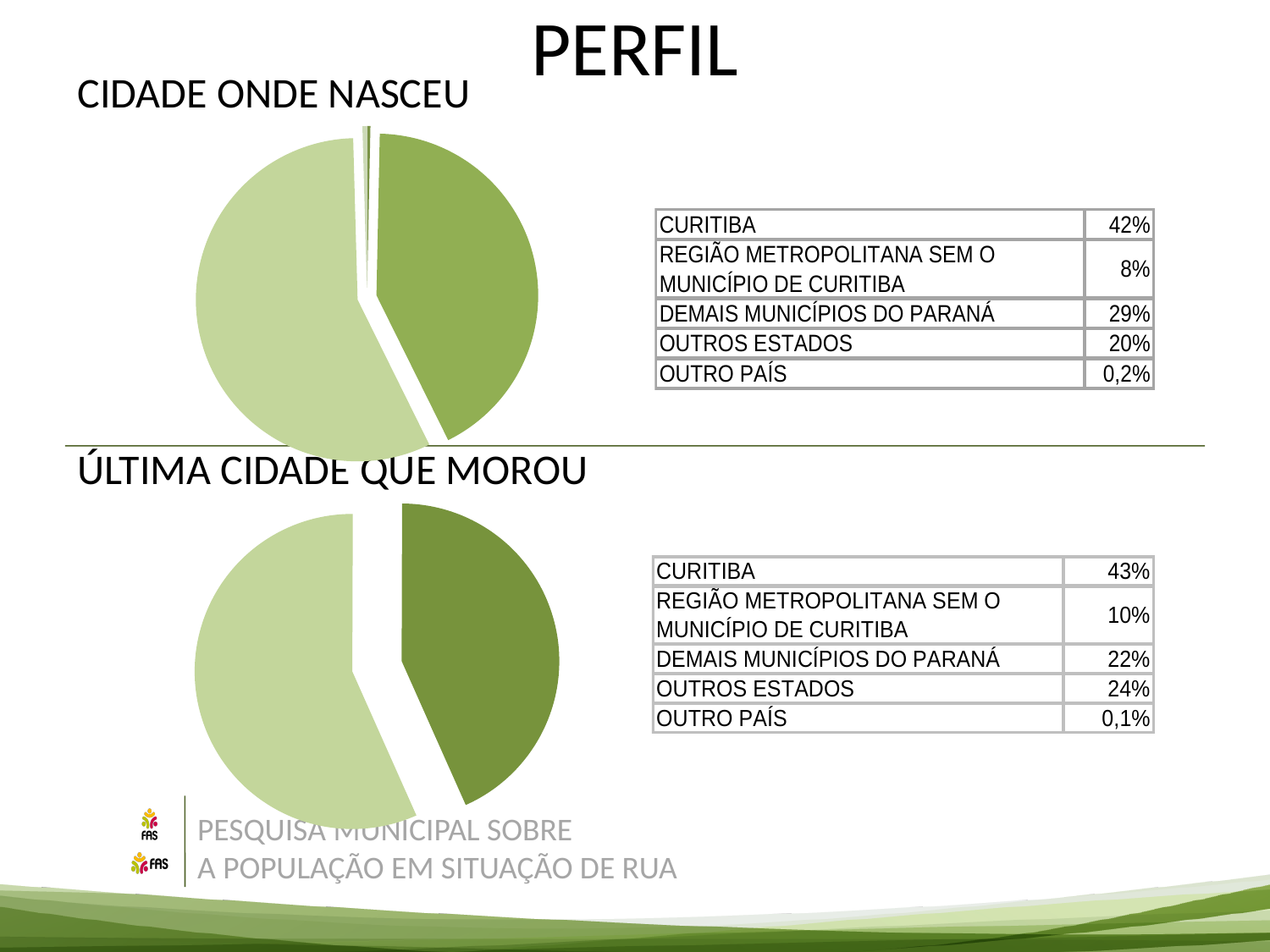
In the 'CIDADE ONDE NASCEU' chart, which category has the smallest share? OUTRO PAÍS In the 'CIDADE ONDE NASCEU' chart, what share is shown for CURITIBA? 42% How many categories are listed for the 'ÚLTIMA CIDADE QUE MOROU' chart? 5 In the 'CIDADE ONDE NASCEU' chart, what share is shown for OUTROS ESTADOS? 20% In the 'ÚLTIMA CIDADE QUE MOROU' chart, what is the difference between the shares for OUTROS ESTADOS and DEMAIS MUNICÍPIOS DO PARANÁ? 2% In the 'ÚLTIMA CIDADE QUE MOROU' chart, what share is shown for REGIÃO METROPOLITANA SEM O MUNICÍPIO DE CURITIBA? 10% In the 'CIDADE ONDE NASCEU' chart, which category has the largest share? CURITIBA In the 'ÚLTIMA CIDADE QUE MOROU' chart, what share is shown for CURITIBA? 43% What is the title of the top chart on the slide? CIDADE ONDE NASCEU In the 'ÚLTIMA CIDADE QUE MOROU' chart, which is larger: the share for DEMAIS MUNICÍPIOS DO PARANÁ or the share for OUTROS ESTADOS? OUTROS ESTADOS What kind of chart is used for 'CIDADE ONDE NASCEU'? Pie chart In the 'CIDADE ONDE NASCEU' chart, what is the difference between the shares for CURITIBA and DEMAIS MUNICÍPIOS DO PARANÁ? 13%